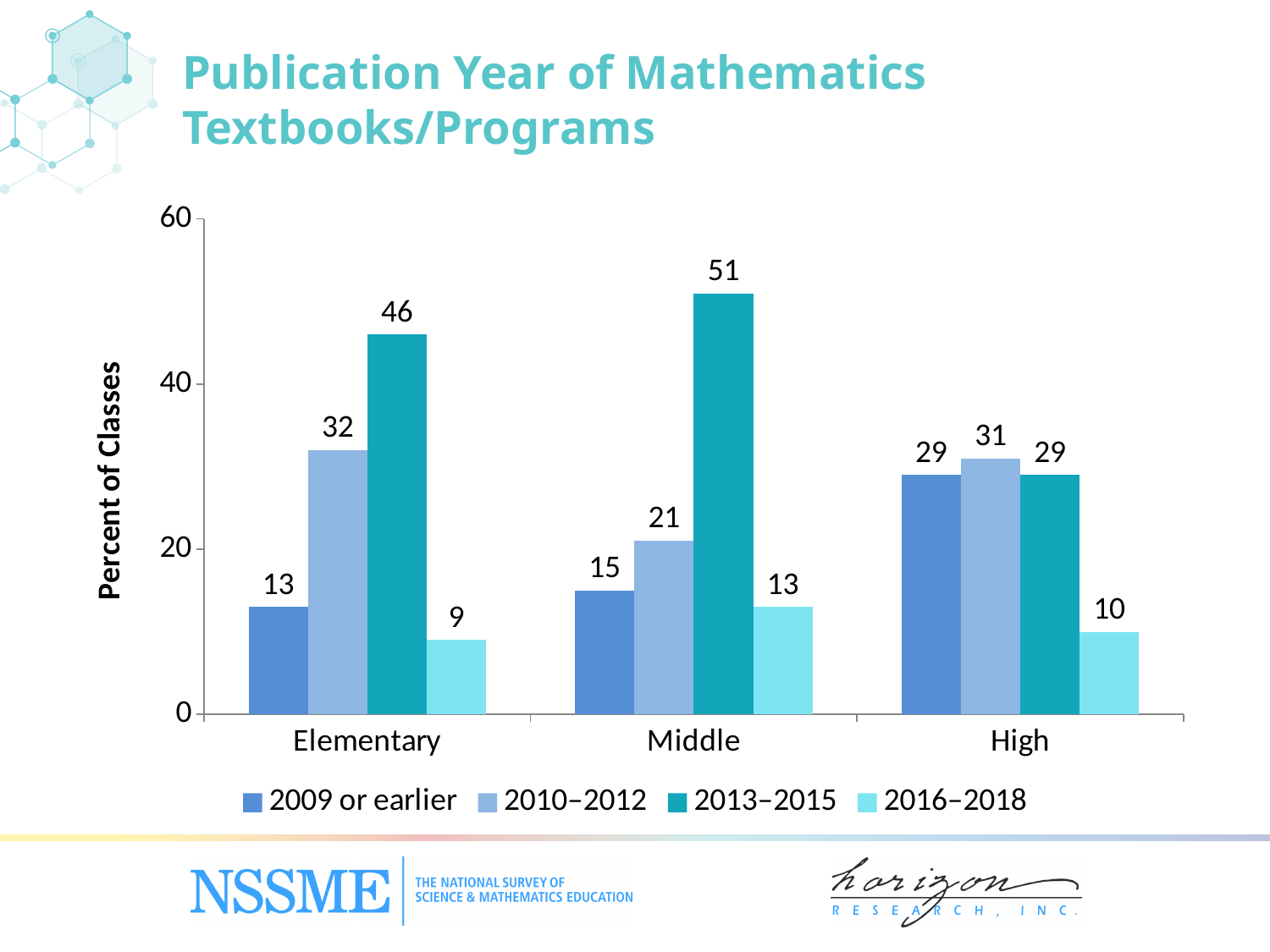
How many categories are shown on the x axis? 3 What is the value for 2013–2015 in the Middle category? 51 What kind of chart is shown on the slide? Bar chart Which category has the highest value for the 2013–2015 series? Middle What is the difference between the 2013–2015 value and the 2010–2012 value in the Elementary category? 14 How many series does the legend list? 4 Does the 2009 or earlier series rise or fall from Elementary to High? Rise Which category has the lowest value for the 2009 or earlier series? Elementary What is the label of the y axis? Percent of Classes What is the value for 2016–2018 in the Elementary category? 9 Which is larger in the High category: the 2010–2012 value or the 2016–2018 value? 2010–2012 What is the value for 2009 or earlier in the High category? 29